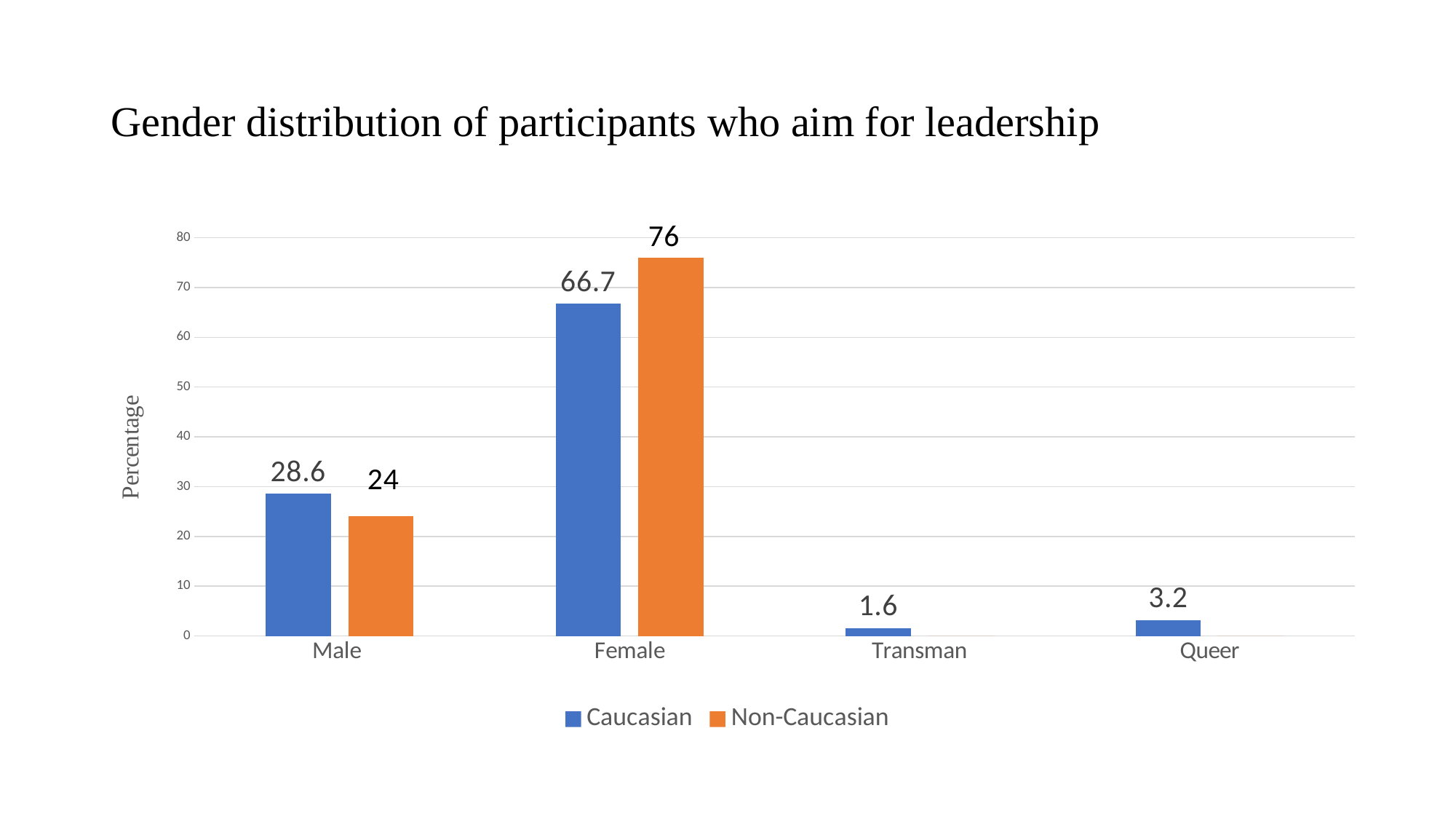
What is the difference between the Non-Caucasian and Caucasian values for Female? 9.3 What is the Caucasian value for Transman? 1.6 What is the Non-Caucasian value for Female? 76 For Male, which is larger: the Caucasian value or the Non-Caucasian value? Caucasian What is the label of the vertical axis? Percentage Which category has the lowest Caucasian value? Transman What kind of chart is shown on the slide? Bar chart Which category has the highest Caucasian value? Female How many categories are shown on the x axis? 4 How many series does the legend list? 2 What is the Caucasian value for Male? 28.6 What is the Caucasian value for Queer? 3.2